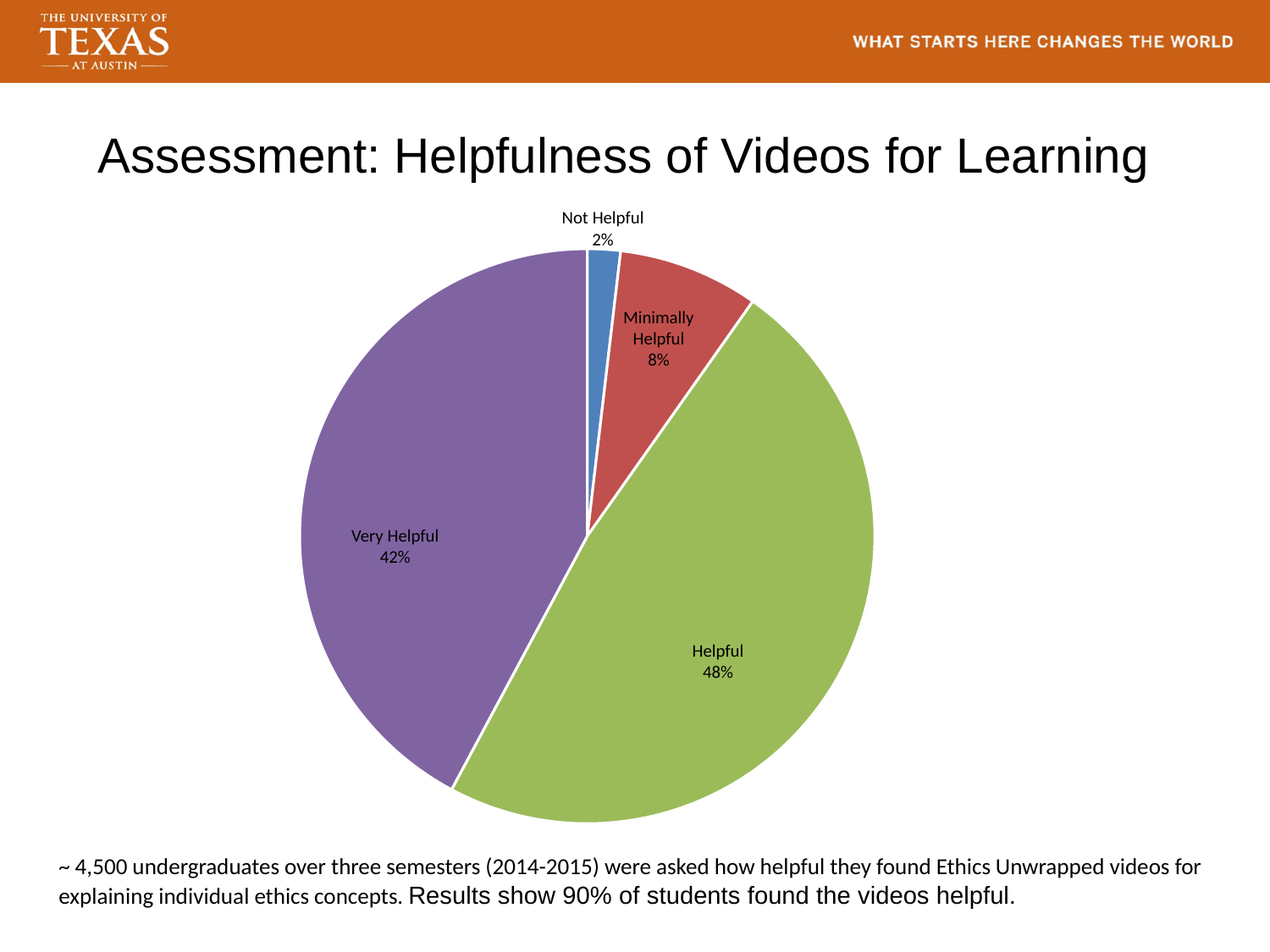
What percentage of students rated the videos as Helpful? 48% What percentage of students rated the videos as Minimally Helpful? 8% Which is larger, the share for Minimally Helpful or the share for Not Helpful? Minimally Helpful What is the combined share of Helpful and Very Helpful? 90% What is the title of the slide containing the chart? Assessment: Helpfulness of Videos for Learning Which category has the largest share of the pie? Helpful How many categories are shown in the pie chart? 4 What is the difference in percentage points between Helpful and Very Helpful? 6 What kind of chart is shown on the slide? pie chart What percentage of students rated the videos as Not Helpful? 2% What percentage of students rated the videos as Very Helpful? 42% Which category has the smallest share of the pie? Not Helpful